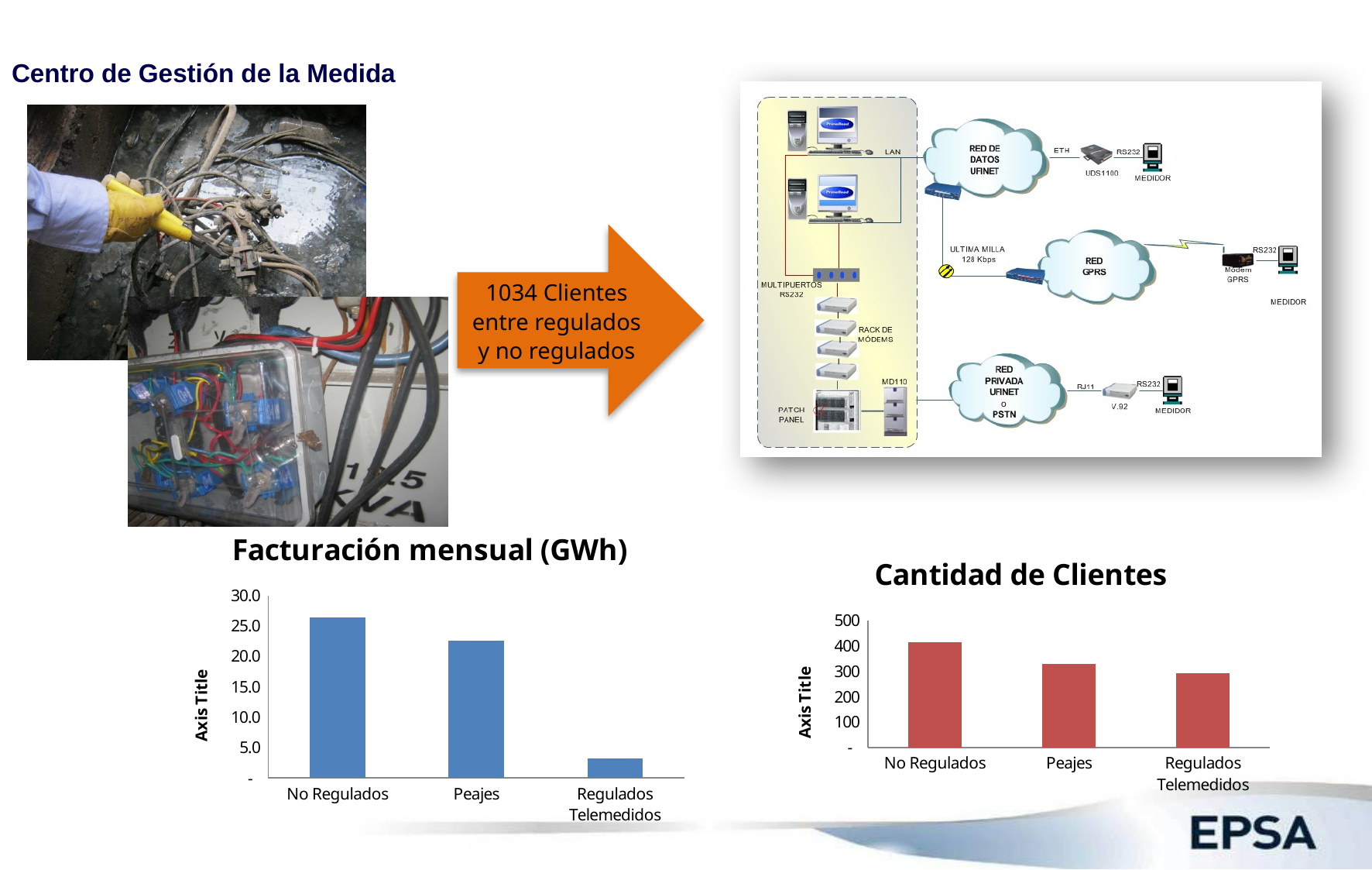
In the 'Cantidad de Clientes' chart, which is larger, the value for Peajes or the value for Regulados Telemedidos? Peajes In the 'Cantidad de Clientes' chart, which category has the highest value? No Regulados In the 'Cantidad de Clientes' chart, what colour are the bars? red In the 'Facturación mensual (GWh)' chart, which category has the lowest value? Regulados Telemedidos In the 'Facturación mensual (GWh)' chart, which category has the highest value? No Regulados In the 'Facturación mensual (GWh)' chart, what kind of chart is shown? bar chart In the 'Facturación mensual (GWh)' chart, do the values rise or fall from left to right along the x axis? fall In the 'Facturación mensual (GWh)' chart, how many categories are plotted? 3 In the 'Facturación mensual (GWh)' chart, is the value for Regulados Telemedidos greater or less than 5.0? less In the 'Cantidad de Clientes' chart, which category has the lowest value? Regulados Telemedidos In the 'Facturación mensual (GWh)' chart, is the value for Peajes greater or less than 20.0? greater